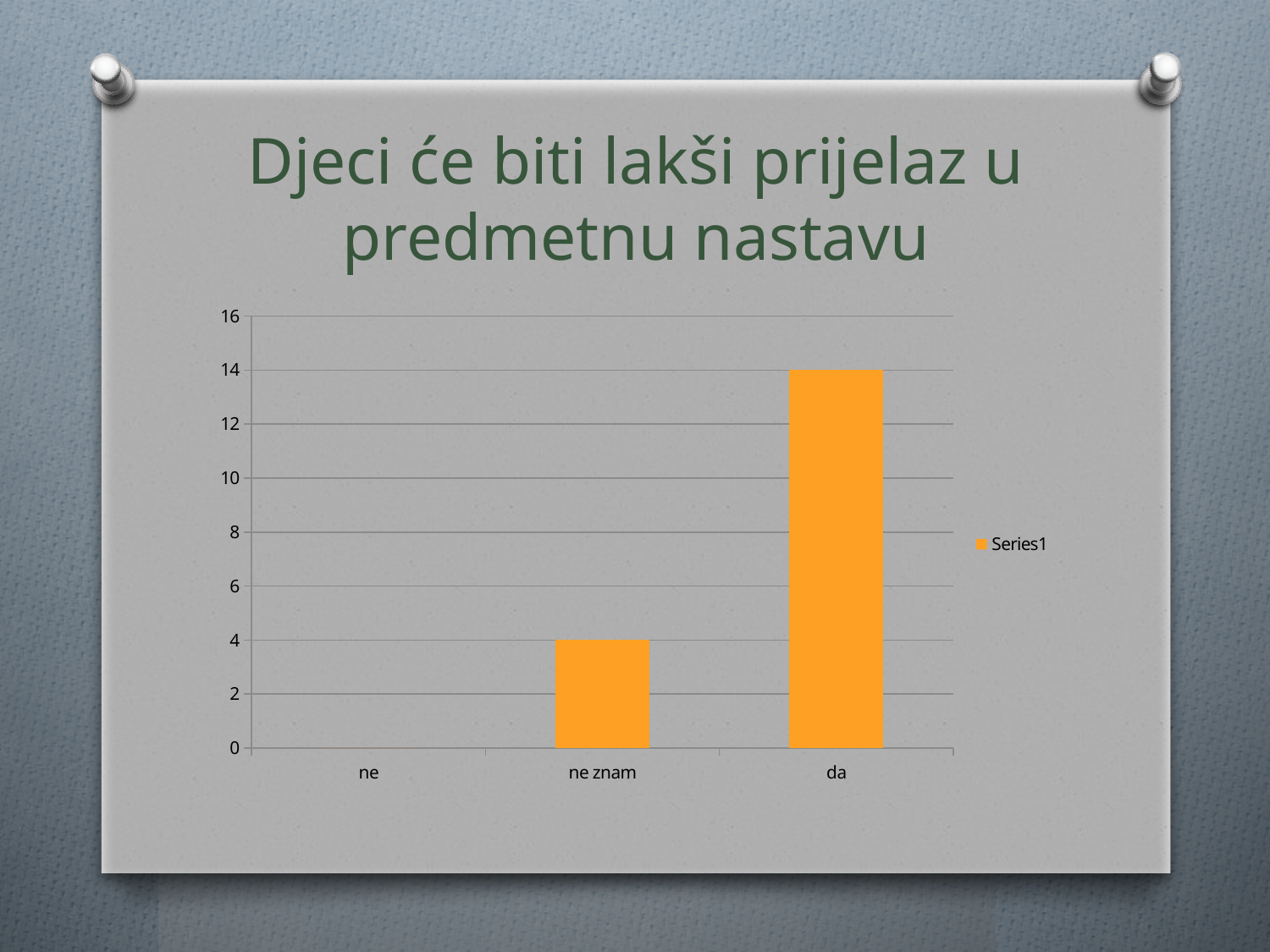
What kind of chart is shown on the slide? bar chart What is the difference between the values for "da" and "ne znam"? 10 Is the value for "da" greater or less than 10? greater Is the value for "ne znam" greater or less than 8? less Which is larger, the value for "ne znam" or the value for "da"? da Which category has the highest value? da How many series does the legend list? 1 How many categories are shown on the x axis? 3 What is the value for "ne znam"? 4 Which category has the lowest value? ne What is the value for "ne"? 0 What is the value for "da"? 14